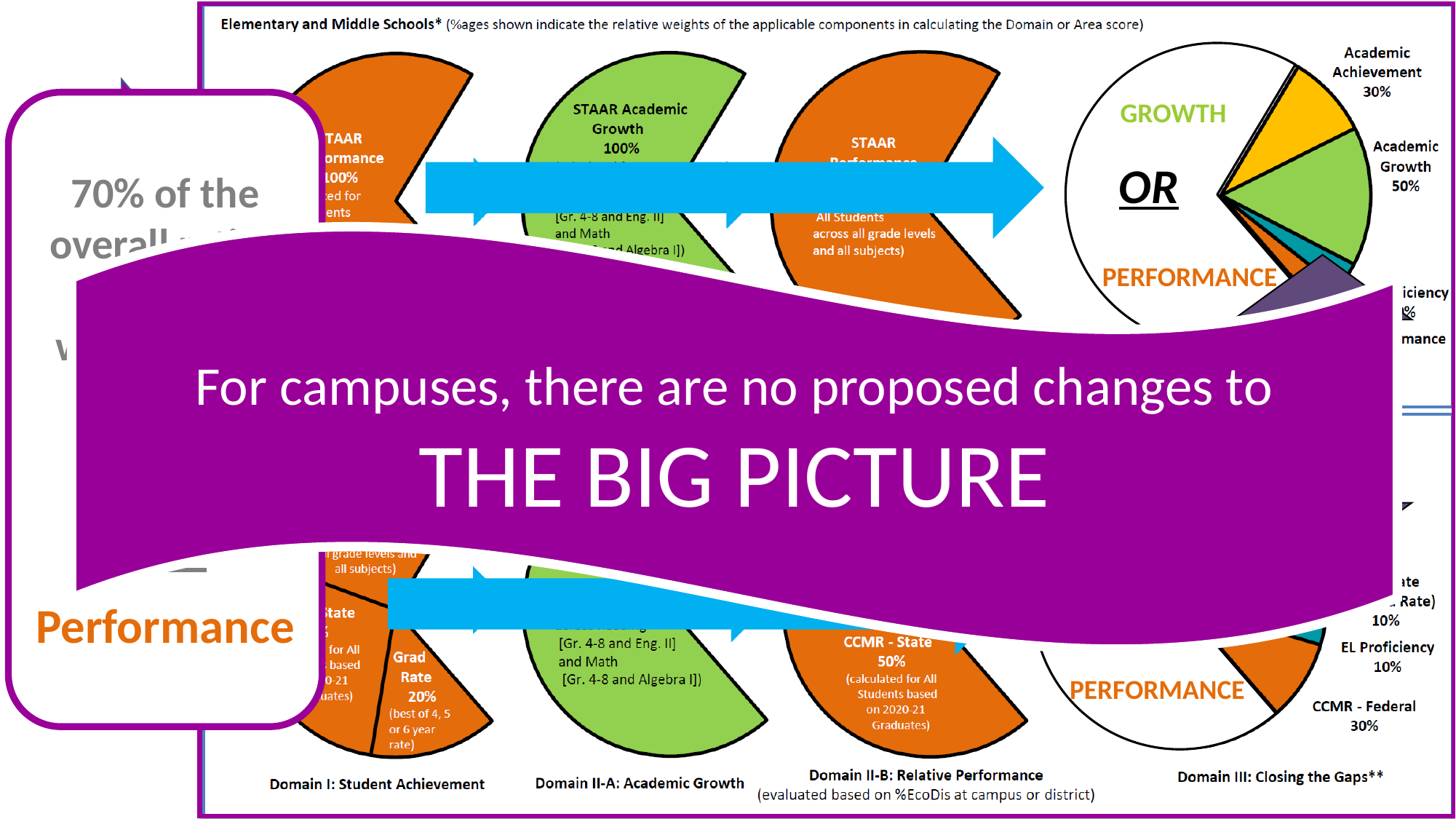
In the bottom-left Domain I: Student Achievement chart, what weight is shown for Grad Rate? 20% What kind of chart is used to show the Domain III: Closing the Gaps weights? Pie chart In the top-right Domain III pie chart, which has the larger weight, Academic Achievement or Academic Growth? Academic Growth In the top-right Domain III pie chart, what weight is shown for Academic Growth? 50% In the top Domain II-A: Academic Growth chart, what weight is shown for STAAR Academic Growth? 100% In the bottom-right Domain III pie chart, what weight is shown for CCMR - Federal? 30% In the bottom Domain II-B: Relative Performance chart, what weight is shown for CCMR - State? 50% In the bottom-right Domain III pie chart, what is the difference between the CCMR - Federal weight and the EL Proficiency weight? 20% In the top-right Domain III pie chart, what weight is shown for Academic Achievement? 30% In the bottom-right Domain III pie chart, which has the larger weight, CCMR - Federal or EL Proficiency? CCMR - Federal In the bottom-right Domain III pie chart, what weight is shown for EL Proficiency? 10% In the top-right Domain III pie chart, what is the difference between the Academic Growth weight and the Academic Achievement weight? 20%